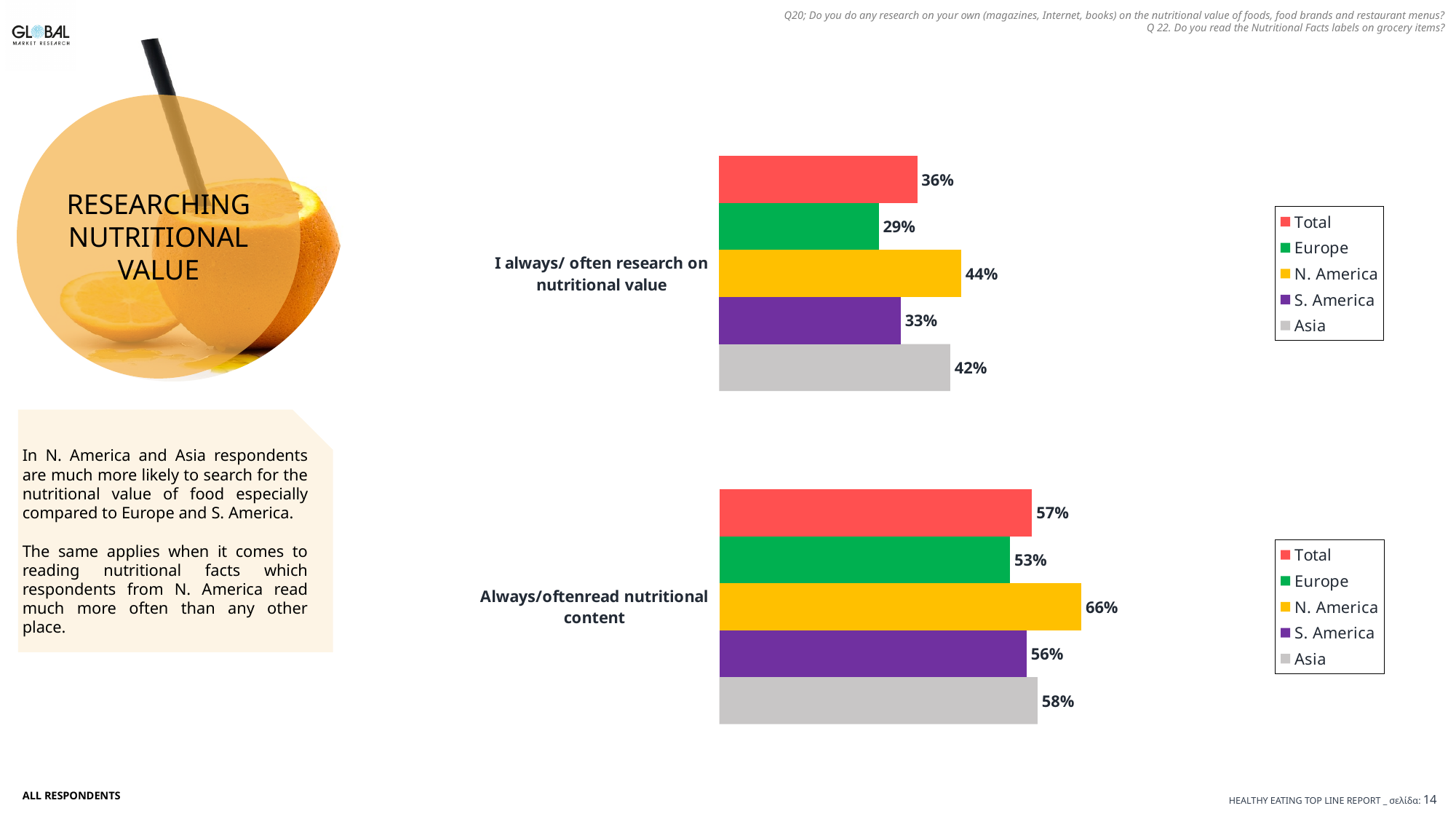
In the top chart ('I always/ often research on nutritional value'), which region has the lowest value? Europe What kind of chart is the bottom chart ('Always/often read nutritional content')? Bar chart In the top chart ('I always/ often research on nutritional value'), what is the difference between Asia and S. America? 9% In the bottom chart, what colour is the bar for S. America? Purple In the top chart ('I always/ often research on nutritional value'), what is the value for Europe? 29% In the bottom chart ('Always/often read nutritional content'), which is larger: the value for Total or the value for Europe? Total In the bottom chart ('Always/often read nutritional content'), what is the difference between N. America and Europe? 13% In the top chart ('I always/ often research on nutritional value'), what is the value for Total? 36% How many series does the legend of the top chart list? 5 In the bottom chart ('Always/often read nutritional content'), what is the value for Asia? 58% In the bottom chart ('Always/often read nutritional content'), which region has the highest value? N. America In the top chart ('I always/ often research on nutritional value'), what is the value for N. America? 44%